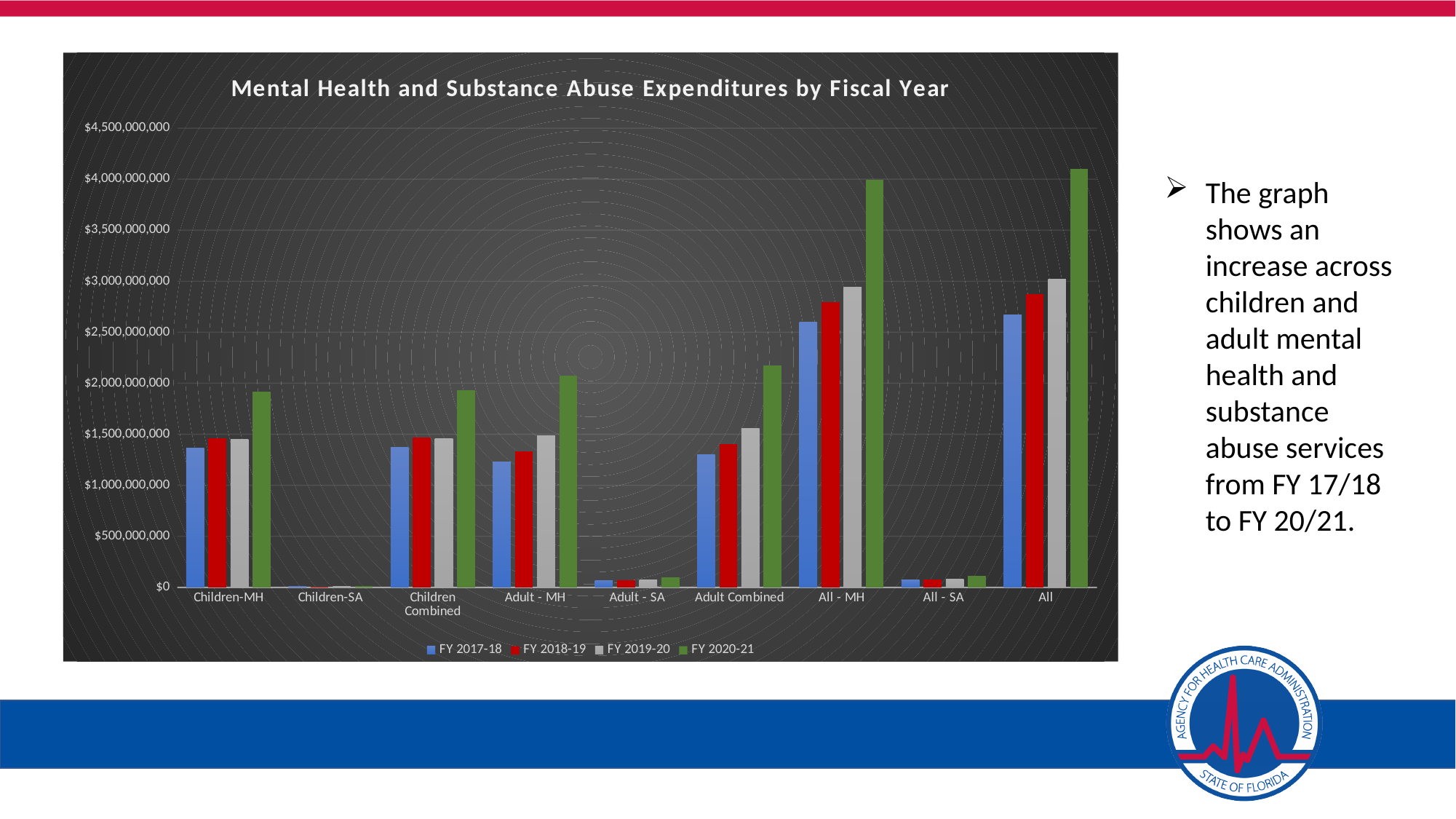
Is the value for All in FY 2017-18 greater or less than $2,500,000,000? greater Is the value for Adult Combined in FY 2020-21 greater or less than $2,000,000,000? greater What is the title of the chart? Mental Health and Substance Abuse Expenditures by Fiscal Year Which category has the lowest expenditures across all fiscal years? Children-SA Which category and fiscal year has the tallest bar in the chart? All, FY 2020-21 How many categories are shown on the x axis? 9 Is the value for Children-MH in FY 2020-21 greater or less than $2,000,000,000? less How many series does the legend list? 4 Which is larger in FY 2020-21: All - MH or Adult Combined? All - MH What type of chart is shown on the slide? bar chart Do the Adult - MH expenditures rise or fall from FY 2017-18 to FY 2020-21? rise